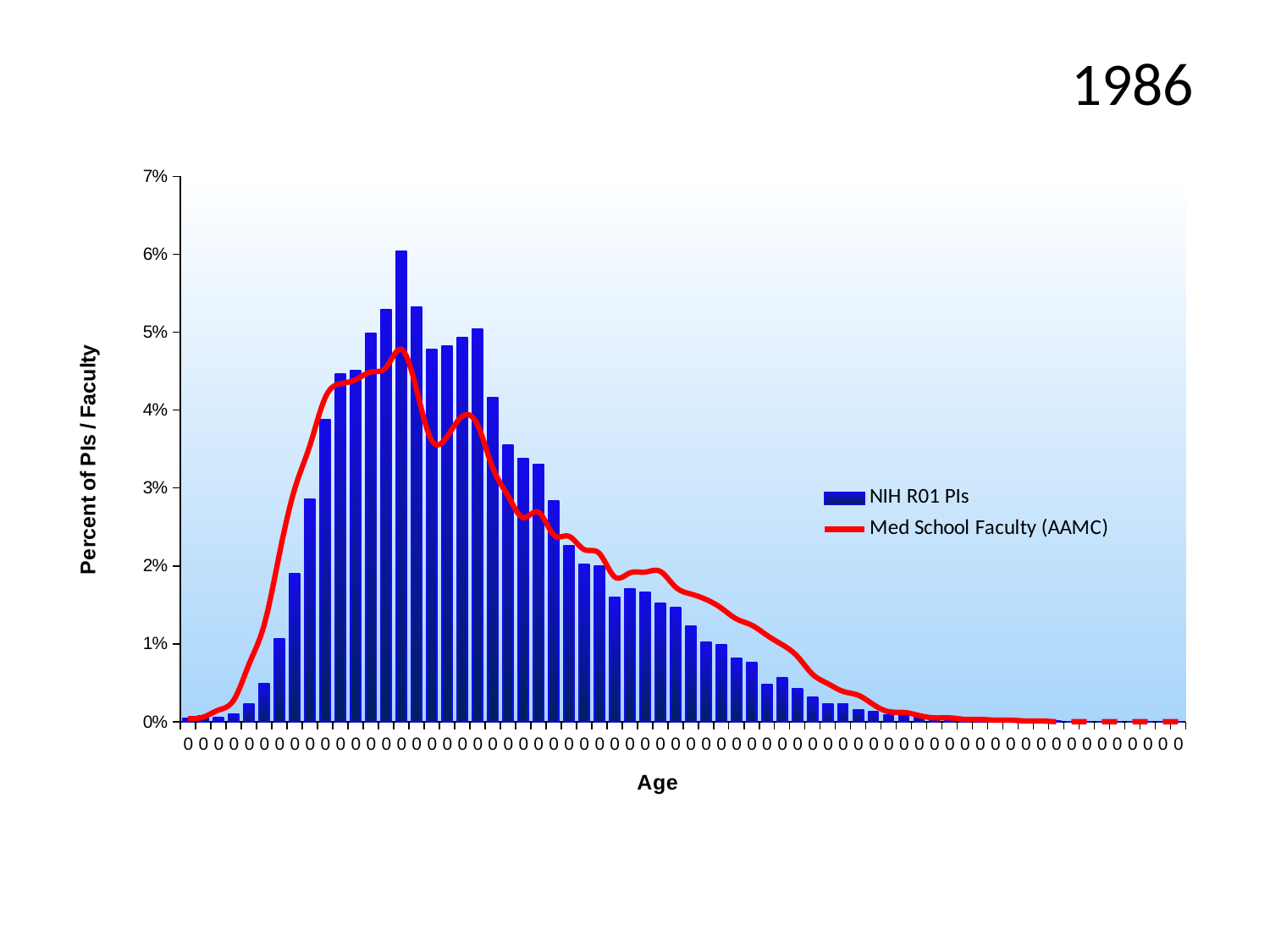
Do the NIH R01 PIs bar values rise or fall toward the right end of the x axis? fall Is the value of the tallest NIH R01 PIs bar greater or less than 5%? greater How many series does the legend list? 2 Is the peak value of the Med School Faculty (AAMC) line greater or less than 4%? greater Is the value of the NIH R01 PIs bars at the far right end of the x axis greater or less than 1%? less What year is shown as the title of the slide? 1986 What kind of chart is shown on the slide? bar chart with a line overlay What are the two series named in the legend? NIH R01 PIs and Med School Faculty (AAMC) Which series reaches a higher peak value, NIH R01 PIs or Med School Faculty (AAMC)? NIH R01 PIs